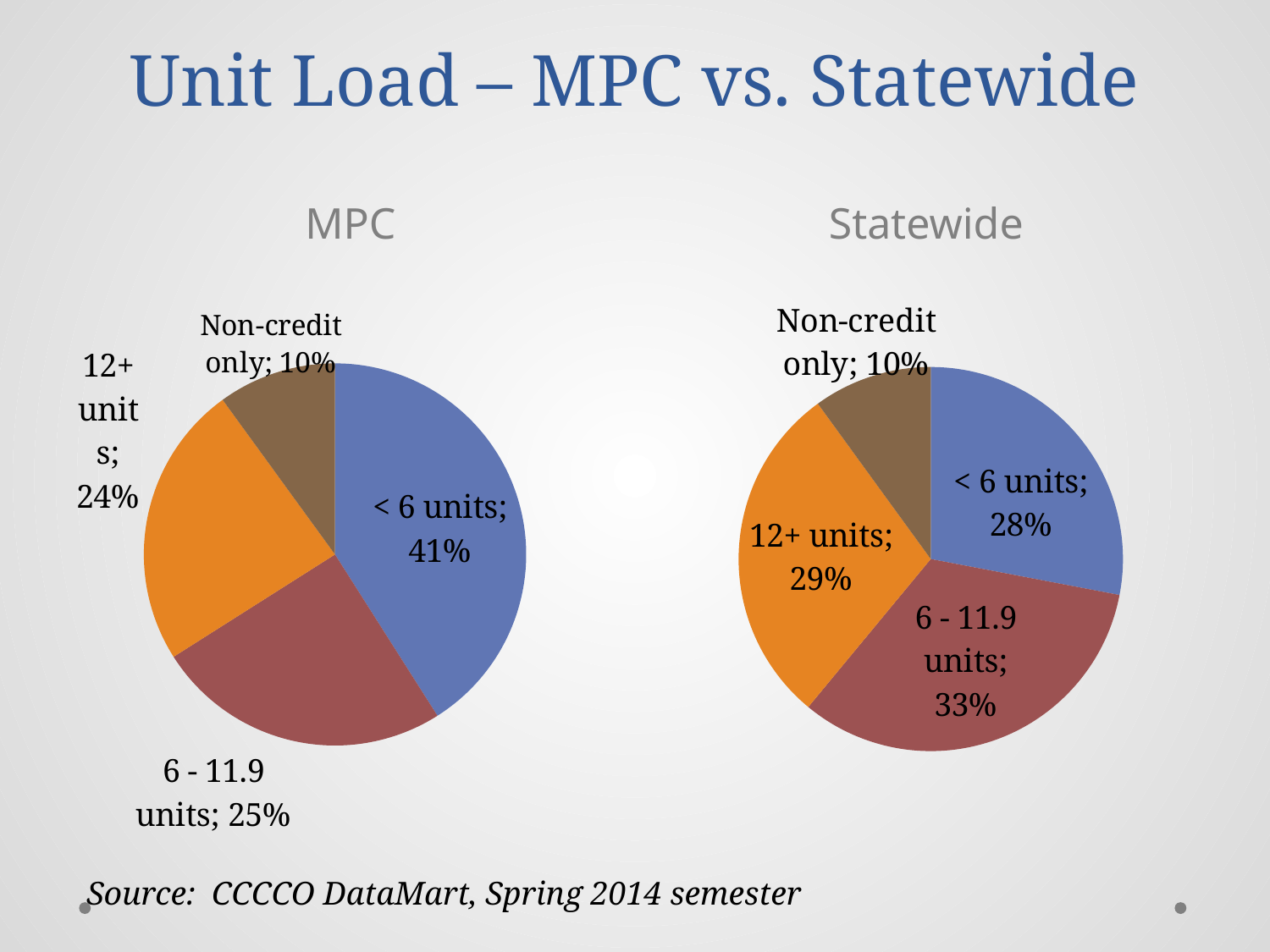
In the Statewide pie chart, what share of students take 12+ units? 29% In the MPC pie chart, what share of students take < 6 units? 41% Which is larger: the 12+ units share in the MPC chart or the 12+ units share in the Statewide chart? Statewide What is the difference between the < 6 units share in the MPC chart and the < 6 units share in the Statewide chart? 13 percentage points In the Statewide pie chart, what share of students take 6 - 11.9 units? 33% What type of chart is used for the Statewide data? Pie chart In the MPC pie chart, which category has the largest share? < 6 units What colour is the 6 - 11.9 units slice in the MPC pie chart? Red In the MPC pie chart, what share of students are Non-credit only? 10% How many categories does the MPC pie chart show? 4 In the Statewide pie chart, which category has the smallest share? Non-credit only In the Statewide pie chart, which category has the largest share? 6 - 11.9 units